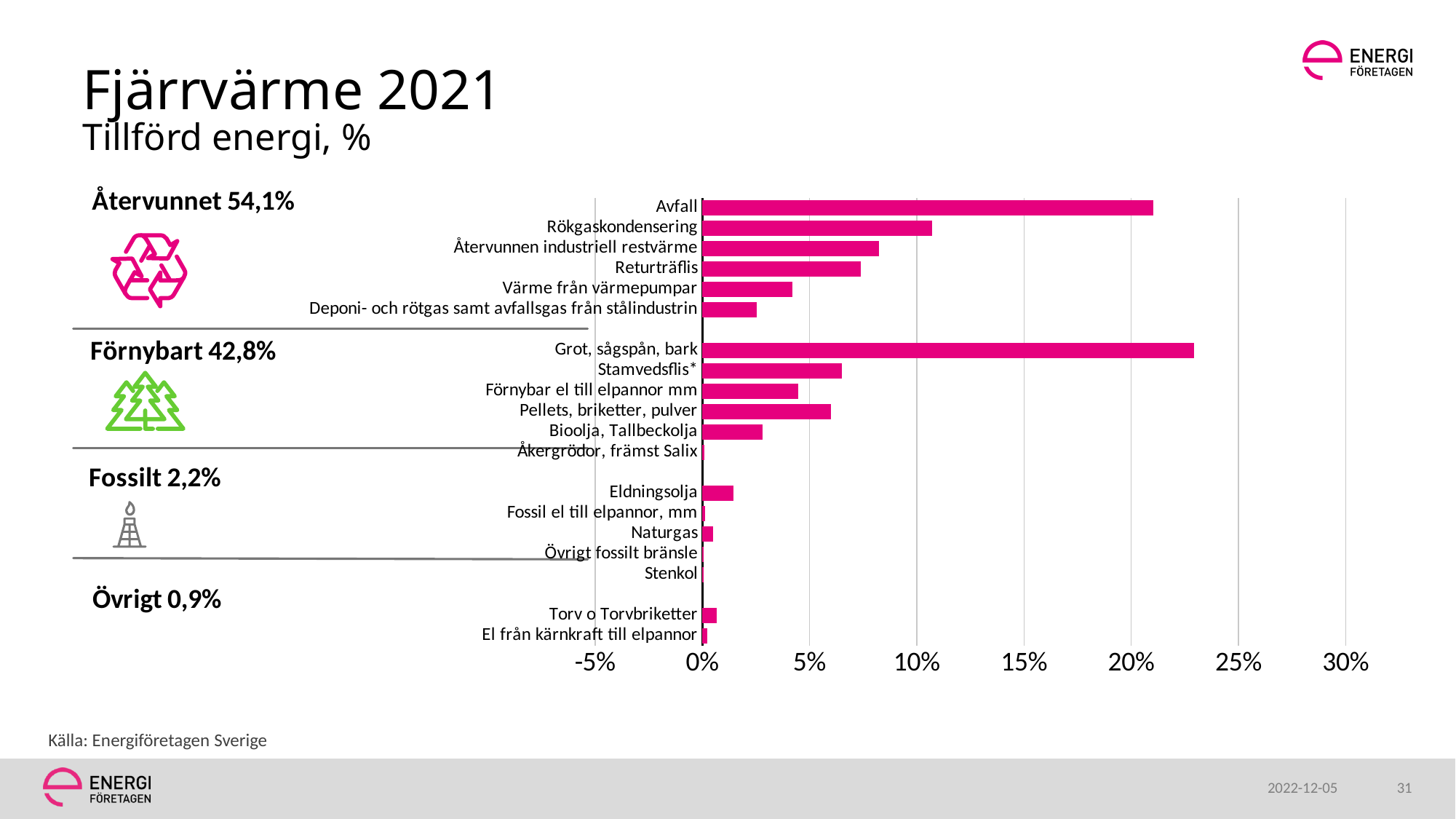
Which is larger, the value for Avfall or the value for Rökgaskondensering? Avfall Is the value for Pellets, briketter, pulver greater or less than 5%? greater Which is larger, the value for Eldningsolja or the value for Naturgas? Eldningsolja Is the value for Eldningsolja greater or less than 5%? less What kind of chart is shown on the slide? bar chart Is the value for Avfall greater or less than 20%? greater Which category has the highest value in the chart? Grot, sågspån, bark What is the title of the slide containing the chart? Fjärrvärme 2021 How many categories (bars) are plotted in the chart? 19 What is the highest value shown on the chart's horizontal axis? 30%